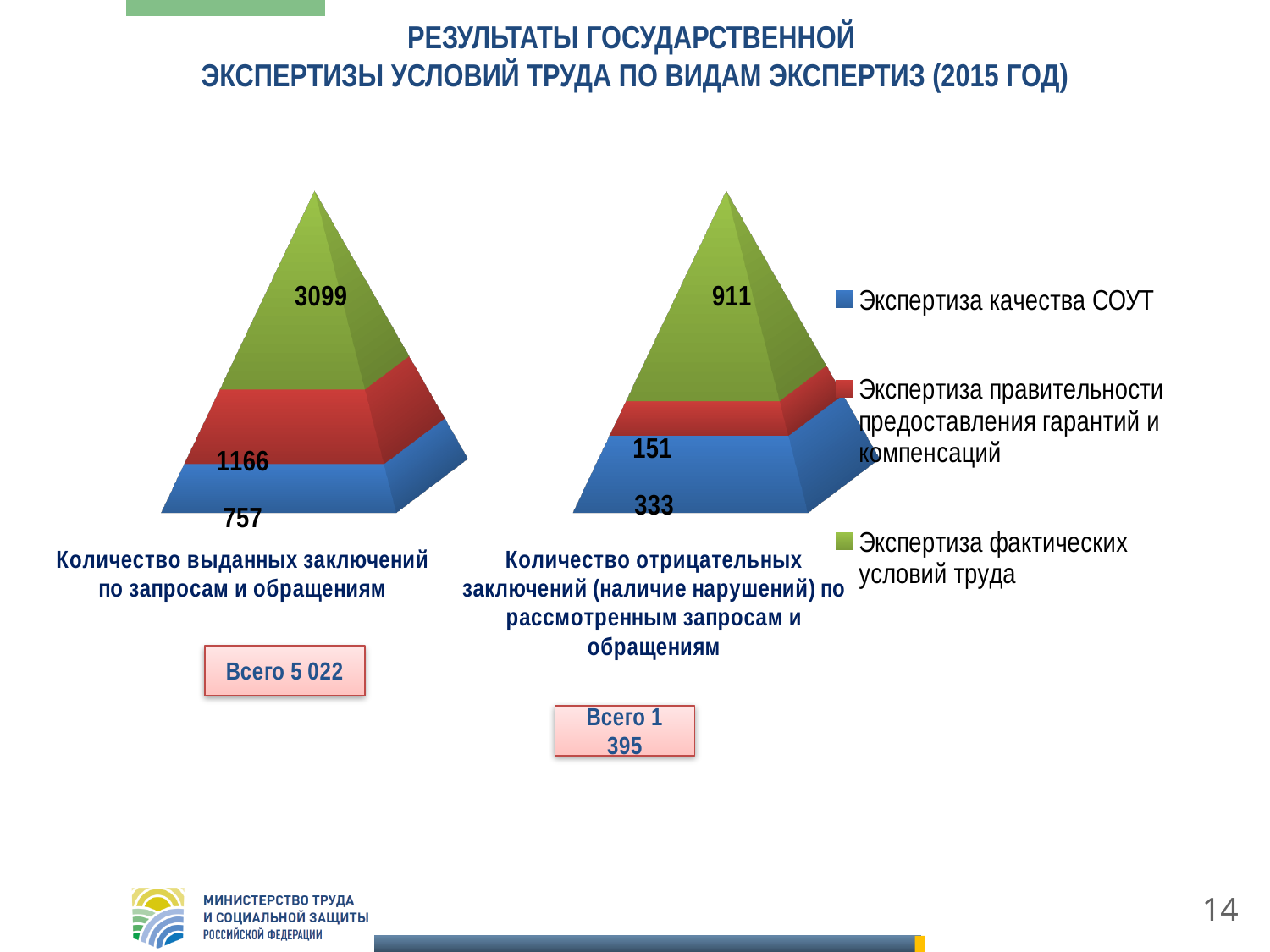
In the right chart (Количество отрицательных заключений), what is the value for Экспертиза качества СОУТ? 333 In the right chart (Количество отрицательных заключений), what is the value for Экспертиза правительности предоставления гарантий и компенсаций? 151 In the left chart (Количество выданных заключений), which type of expertise has the highest value? Экспертиза фактических условий труда How many series does the legend list? 3 In the left chart (Количество выданных заключений), what is the difference between the values for Экспертиза фактических условий труда and Экспертиза правительности предоставления гарантий и компенсаций? 1933 In the left chart (Количество выданных заключений по запросам и обращениям), what is the value for Экспертиза качества СОУТ? 757 Which colour represents Экспертиза качества СОУТ in the legend? Blue What is the total shown for the left chart (Количество выданных заключений по запросам и обращениям)? 5 022 In the right chart (Количество отрицательных заключений), which is larger: the value for Экспертиза качества СОУТ or for Экспертиза правительности предоставления гарантий и компенсаций? Экспертиза качества СОУТ What is the total shown for the right chart (Количество отрицательных заключений)? 1 395 In the right chart (Количество отрицательных заключений), which type of expertise has the lowest value? Экспертиза правительности предоставления гарантий и компенсаций In the left chart (Количество выданных заключений по запросам и обращениям), what is the value for Экспертиза фактических условий труда? 3099